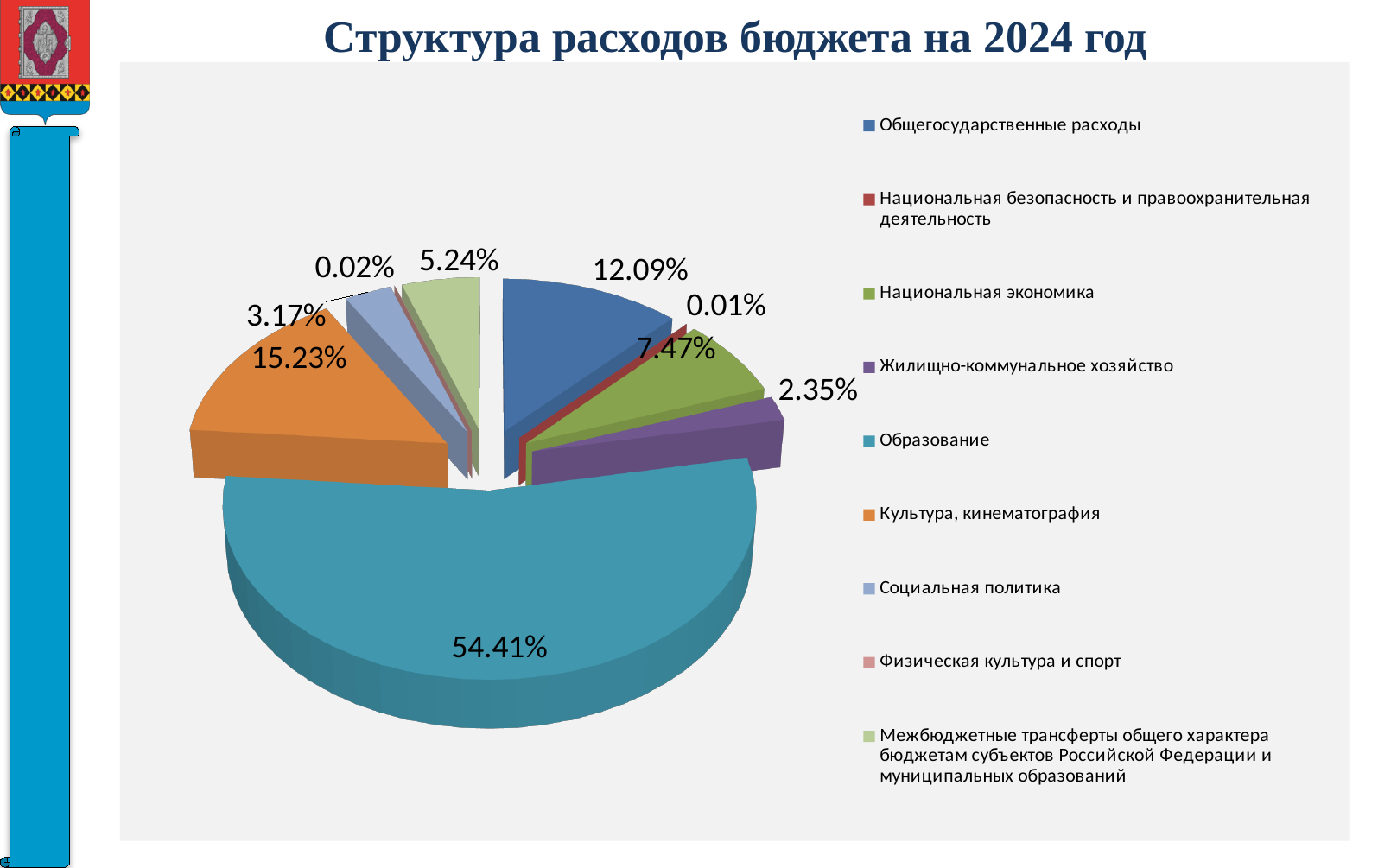
What share is shown for Культура, кинематография? 15.23% How many categories does the legend list? 9 What is the difference between the share for Образование and the share for Культура, кинематография? 39.18% What share is shown for Национальная экономика? 7.47% What kind of chart is shown on the slide? pie chart Which category has the largest share of the pie? Образование What is the title of the chart? Структура расходов бюджета на 2024 год What share is shown for Жилищно-коммунальное хозяйство? 2.35% What share is shown for Общегосударственные расходы? 12.09% What share of the budget expenditure goes to Образование? 54.41% Which is larger: the share for Культура, кинематография or the share for Общегосударственные расходы? Культура, кинематография Which category has the smallest share of the pie? Национальная безопасность и правоохранительная деятельность